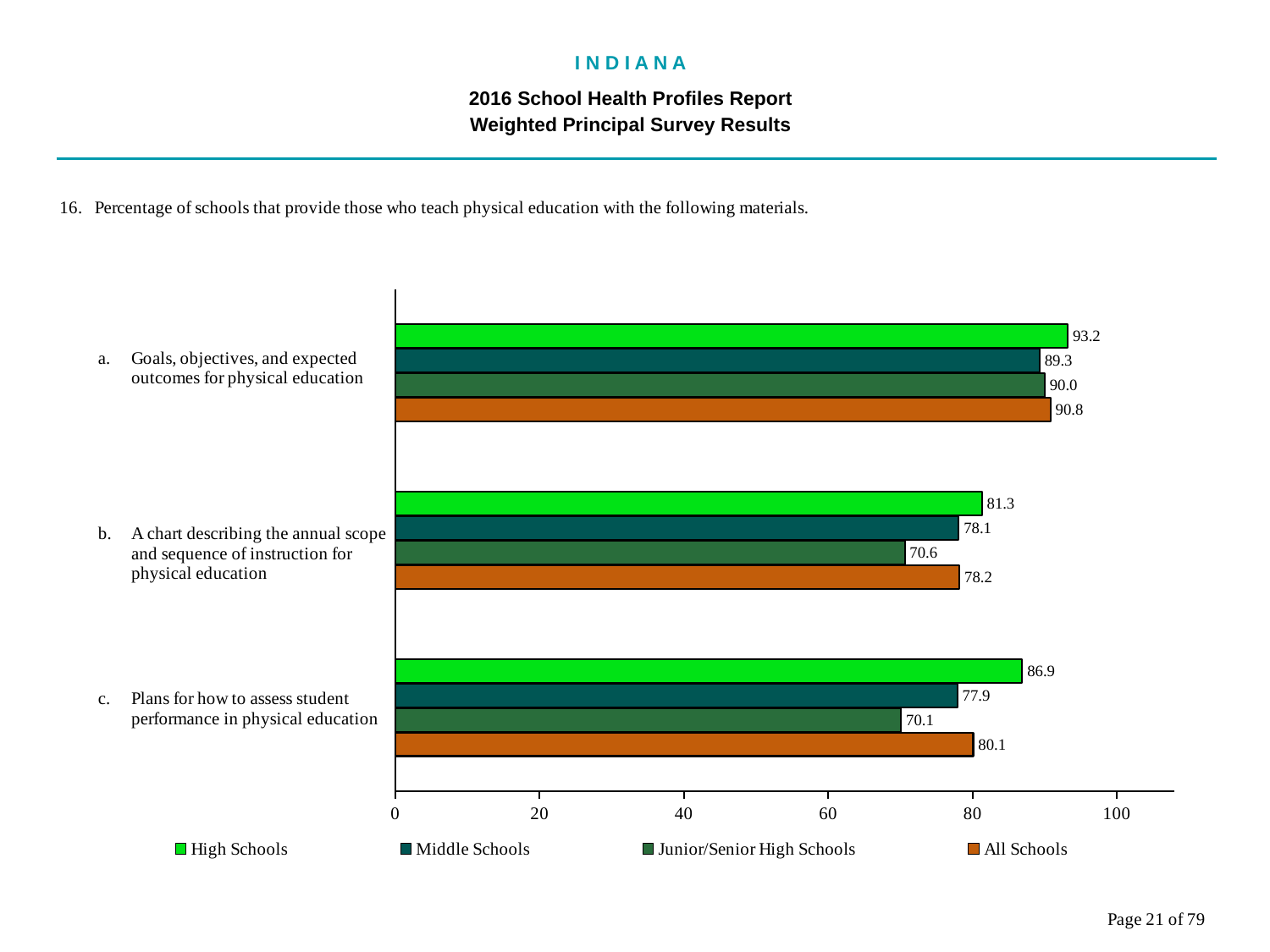
Which category has the highest value for Middle Schools? Goals, objectives, and expected outcomes for physical education What is the value for All Schools for 'Plans for how to assess student performance in physical education'? 80.1 Which is larger for 'A chart describing the annual scope and sequence of instruction for physical education': the High Schools value or the All Schools value? High Schools What is the difference between the High Schools and Middle Schools values for 'Plans for how to assess student performance in physical education'? 9.0 Which series is shown in orange in the legend? All Schools Is the Junior/Senior High Schools value for 'Plans for how to assess student performance in physical education' greater or less than 80? less What kind of chart is shown on the slide? bar chart What is the value for High Schools for 'Goals, objectives, and expected outcomes for physical education'? 93.2 What is the value for Junior/Senior High Schools for 'A chart describing the annual scope and sequence of instruction for physical education'? 70.6 How many categories (materials) are shown in the chart? 3 How many series does the legend list? 4 Which category has the lowest value for Junior/Senior High Schools? Plans for how to assess student performance in physical education